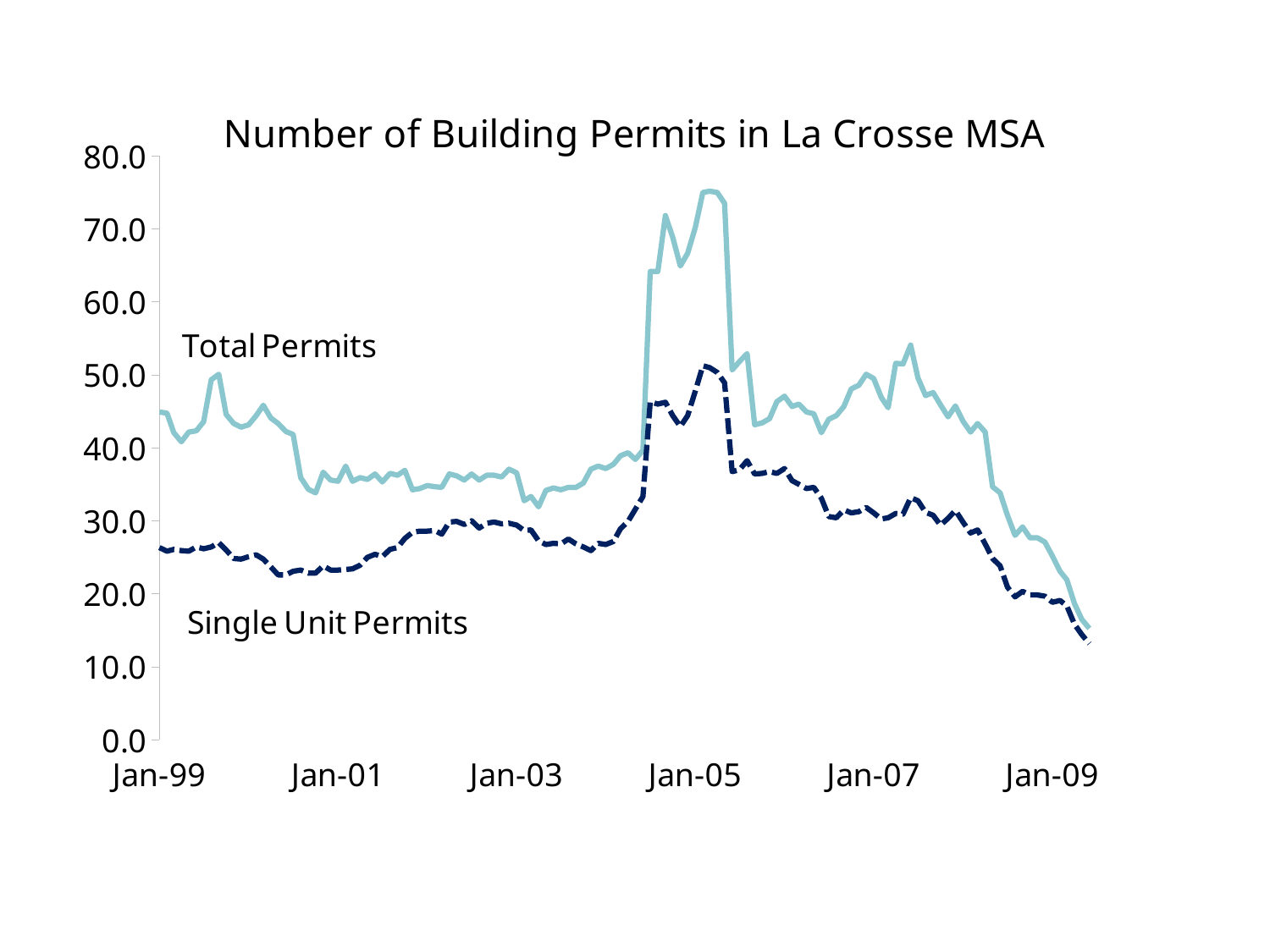
Which series is higher at Jan-07, Total Permits or Single Unit Permits? Total Permits How many series are plotted on the chart? 2 Is the value for Single Unit Permits at Jan-99 greater or less than 30? less Is the value for Total Permits at Jan-03 greater or less than 40? less Do the values for Total Permits rise or fall between Jan-07 and the end of the series? fall Is the peak value of Total Permits greater or less than 70? greater Which series reaches the highest value on the chart? Total Permits Which series is drawn with a dashed line? Single Unit Permits What is the title of the chart? Number of Building Permits in La Crosse MSA What kind of chart is shown on the slide? line chart